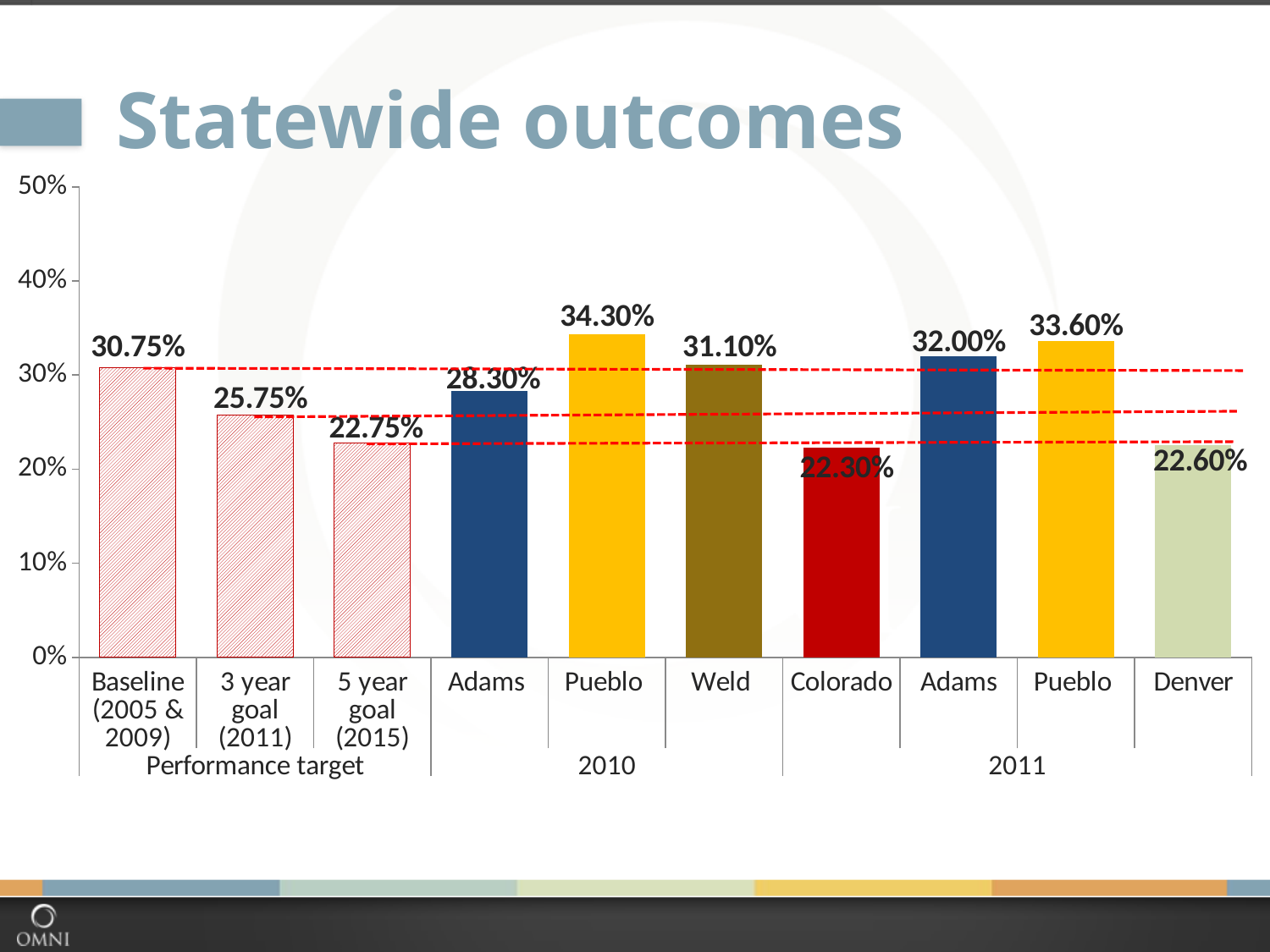
Which bar has the highest value on the chart? Pueblo (2010) What is the value for Pueblo in 2010? 34.30% What is the value for Colorado in 2011? 22.30% Which is larger, the Pueblo value in 2010 or the Pueblo value in 2011? Pueblo in 2010 What is the title of the slide containing the chart? Statewide outcomes Which bar has the lowest value on the chart? Colorado (2011) What is the value for the 5 year goal (2015) bar? 22.75% What is the value for the Baseline (2005 & 2009) bar? 30.75% What is the difference between the Adams value in 2011 and the Adams value in 2010? 3.70% Is the value for Weld in 2010 greater or less than 30%? greater What is the value for Denver in 2011? 22.60% How many bars are plotted on the chart? 10